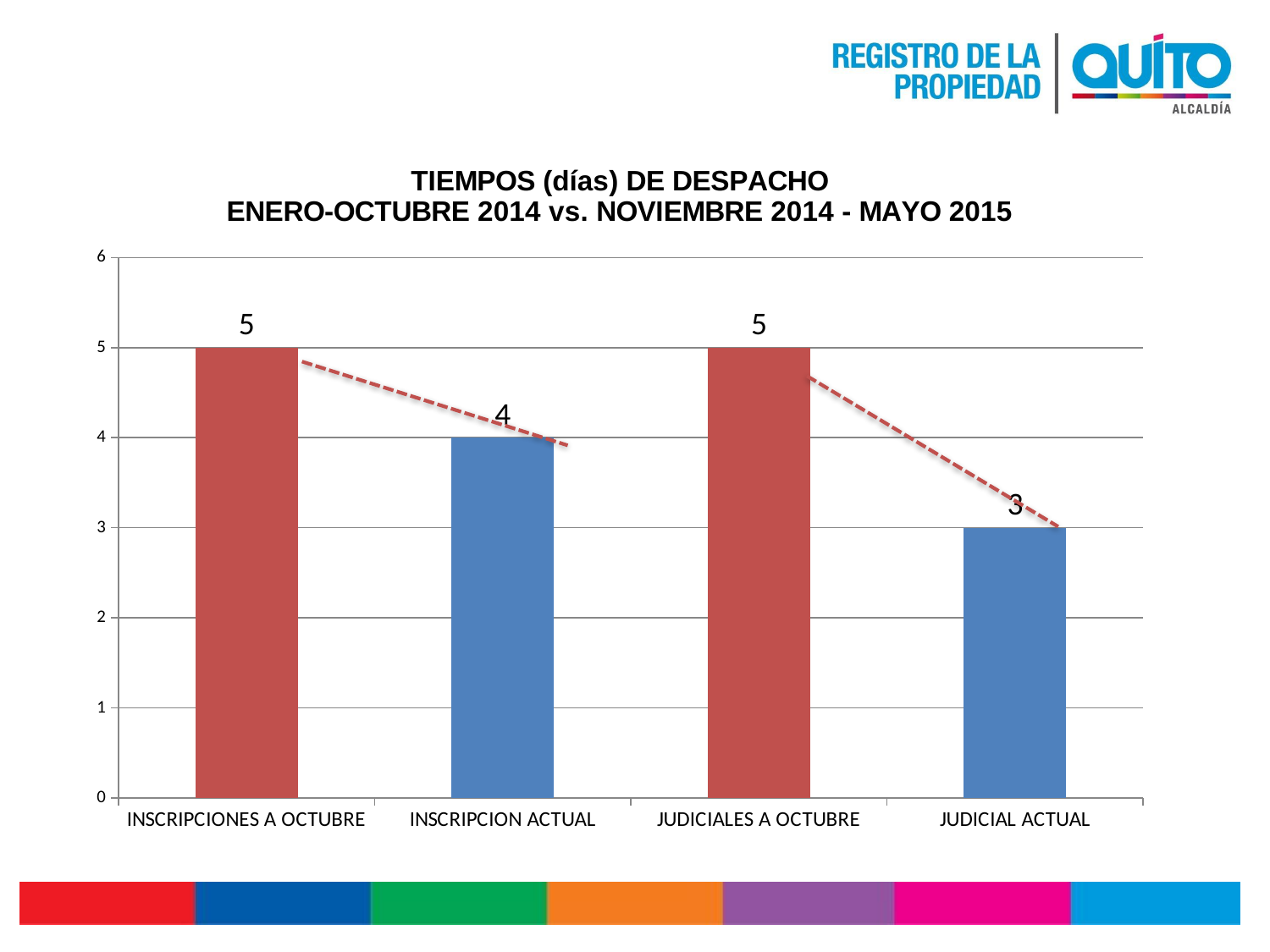
What is the value for INSCRIPCION ACTUAL? 4 What is the title of the chart? TIEMPOS (días) DE DESPACHO ENERO-OCTUBRE 2014 vs. NOVIEMBRE 2014 - MAYO 2015 Which category has the lowest value? JUDICIAL ACTUAL What colour are the bars for the 'A OCTUBRE' categories? Red What is the value for JUDICIALES A OCTUBRE? 5 What is the difference between the values for INSCRIPCIONES A OCTUBRE and INSCRIPCION ACTUAL? 1 What is the value for JUDICIAL ACTUAL? 3 What is the value for INSCRIPCIONES A OCTUBRE? 5 Which is larger, the value for INSCRIPCION ACTUAL or the value for JUDICIAL ACTUAL? INSCRIPCION ACTUAL What is the difference between the values for JUDICIALES A OCTUBRE and JUDICIAL ACTUAL? 2 How many categories are shown on the x axis? 4 What kind of chart is shown on the slide? Bar chart